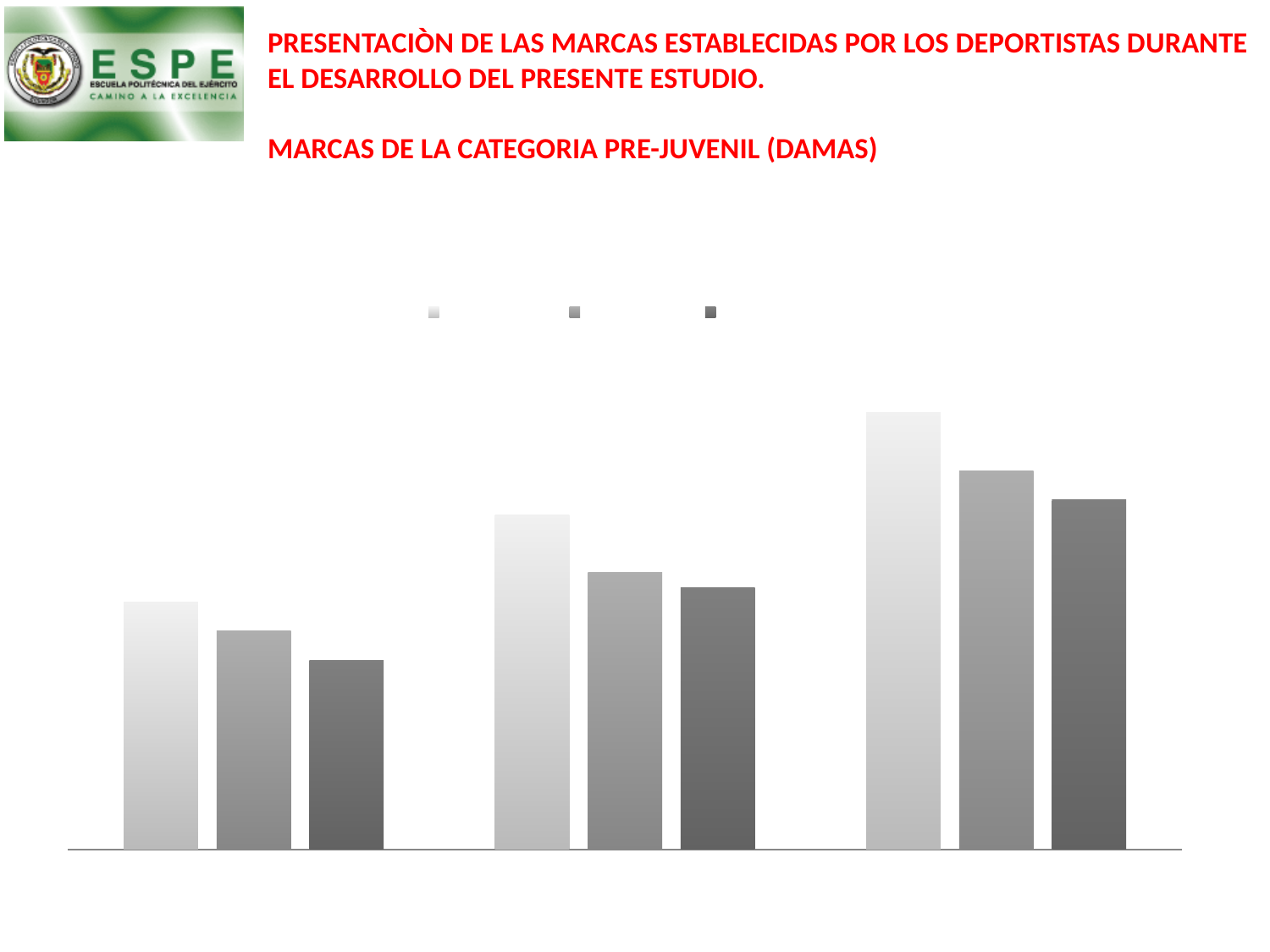
How many series does the chart's legend list? 3 Are the bars in the chart vertical or horizontal? vertical Within each group, which shade of bar is the tallest: the lightest, the medium grey or the darkest? the lightest What kind of chart is shown on the slide? bar chart Which group of bars is the shortest overall: the left, middle or right group? left group What heading is printed directly above the chart on the slide? MARCAS DE LA CATEGORIA PRE-JUVENIL (DAMAS) Is the lightest bar in the middle group taller or shorter than the lightest bar in the right group? shorter Within each group, which shade of bar is the shortest: the lightest, the medium grey or the darkest? the darkest How many groups of bars are plotted along the x axis of the chart? 3 How many bars are in each group of the chart? 3 Do the bar heights rise or fall from the left group to the right group? rise Which group of bars is the tallest overall: the left, middle or right group? right group